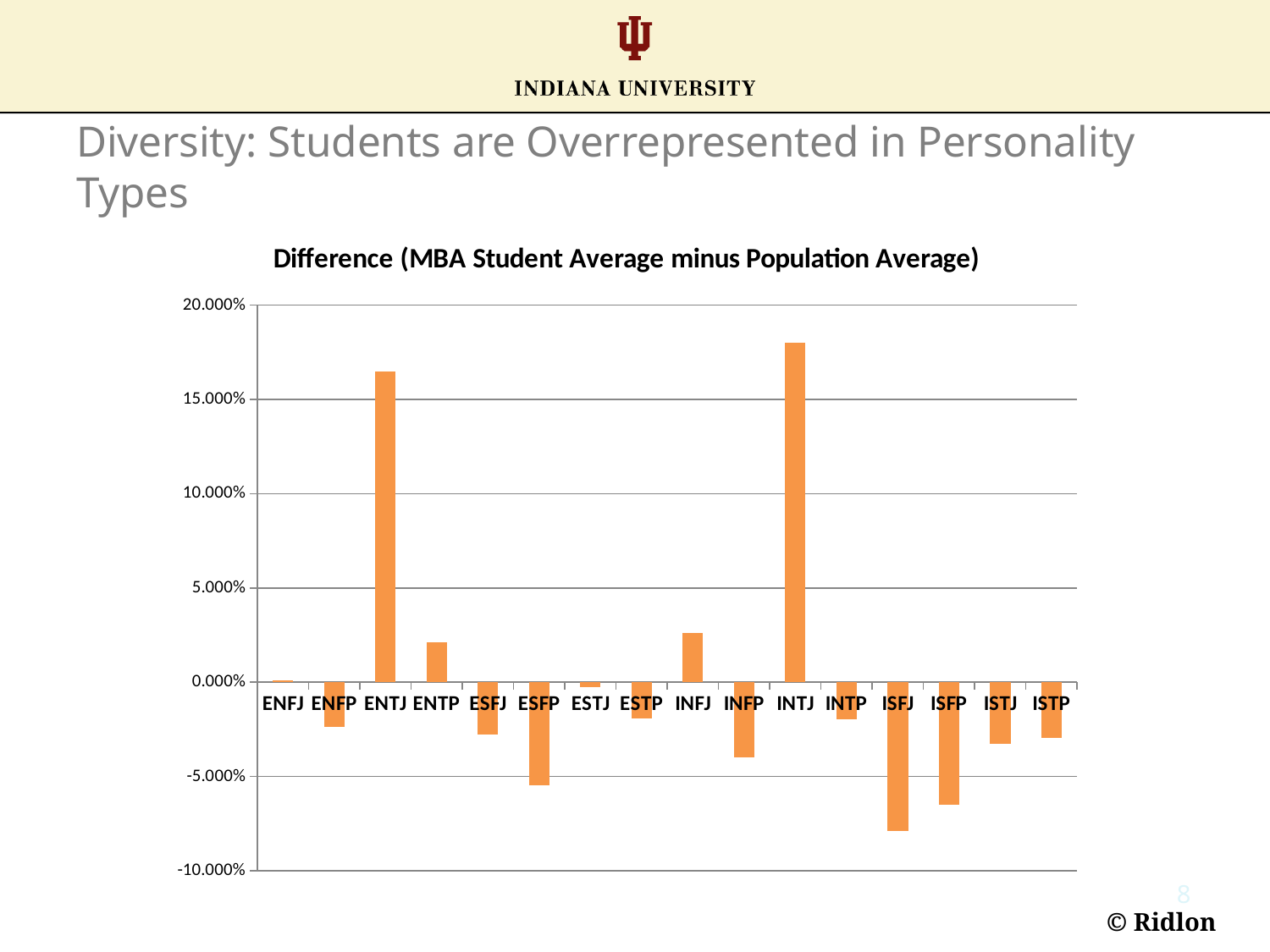
Is the value for ISFJ greater or less than -5.000%? less Which has the larger value, INFJ or ESFP? INFJ Is the value for INFP greater or less than -5.000%? greater Which personality type has the highest value in the chart? INTJ Which personality type has the lowest value in the chart? ISFJ Is the value for ENTJ greater or less than 15.000%? greater How many personality types are shown on the x axis of the chart? 16 Which has the larger value, ENTJ or INTJ? INTJ What kind of chart is shown on the slide? bar chart What is the title of the chart? Difference (MBA Student Average minus Population Average)